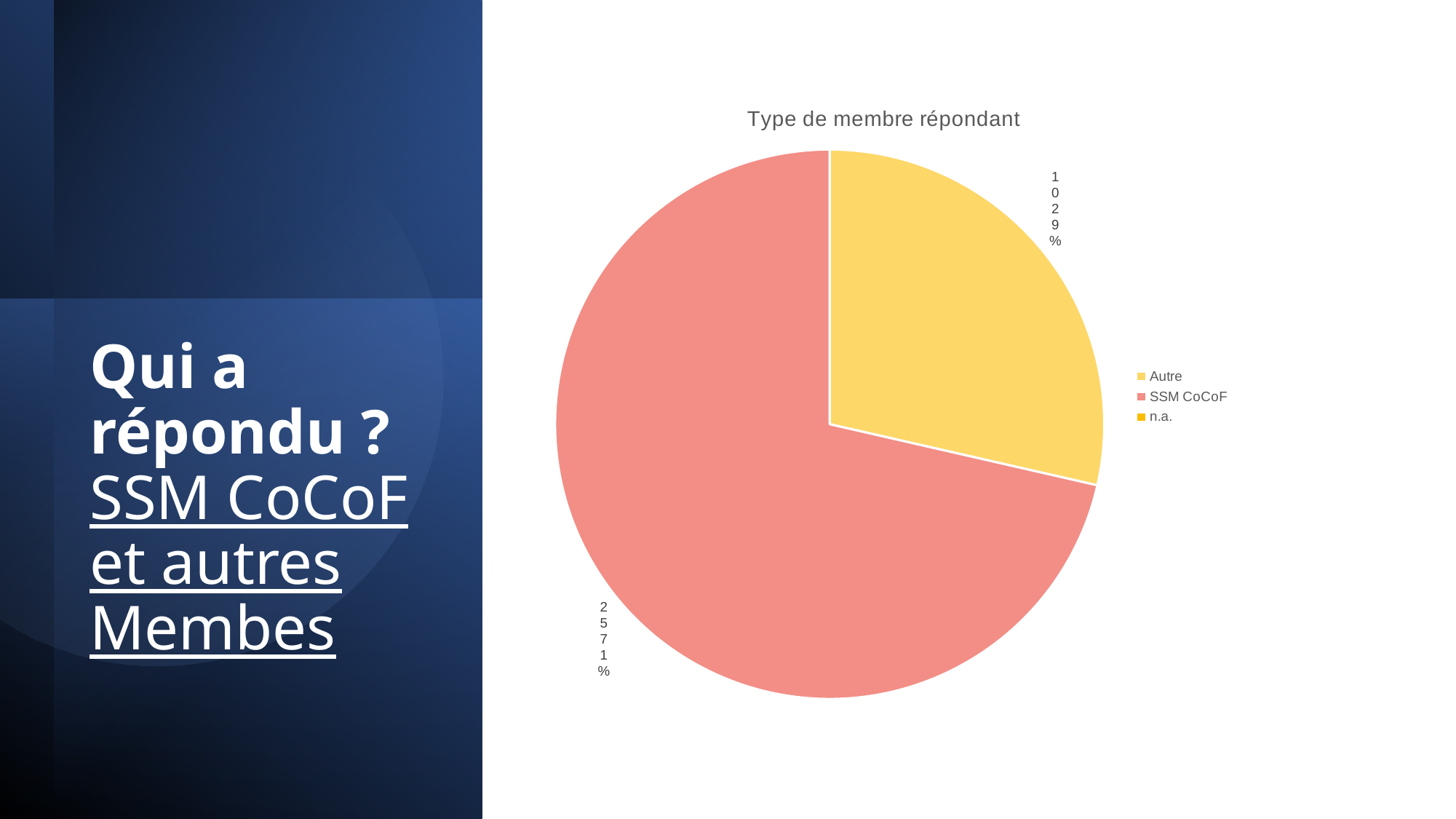
What is the count value shown for the Autre slice? 10 What percentage share of the pie does the Autre slice represent? 29% What is the title of the chart? Type de membre répondant How many entries does the chart legend list? 3 Which legend entry is shown in red/salmon colour? SSM CoCoF What percentage share of the pie does the SSM CoCoF slice represent? 71% Which slice is larger, Autre or SSM CoCoF? SSM CoCoF What is the difference between the count for SSM CoCoF and the count for Autre? 15 Which category has the largest slice of the pie? SSM CoCoF What kind of chart is shown on the slide? Pie chart What is the difference in percentage points between the SSM CoCoF share and the Autre share? 42 What is the count value shown for the SSM CoCoF slice? 25